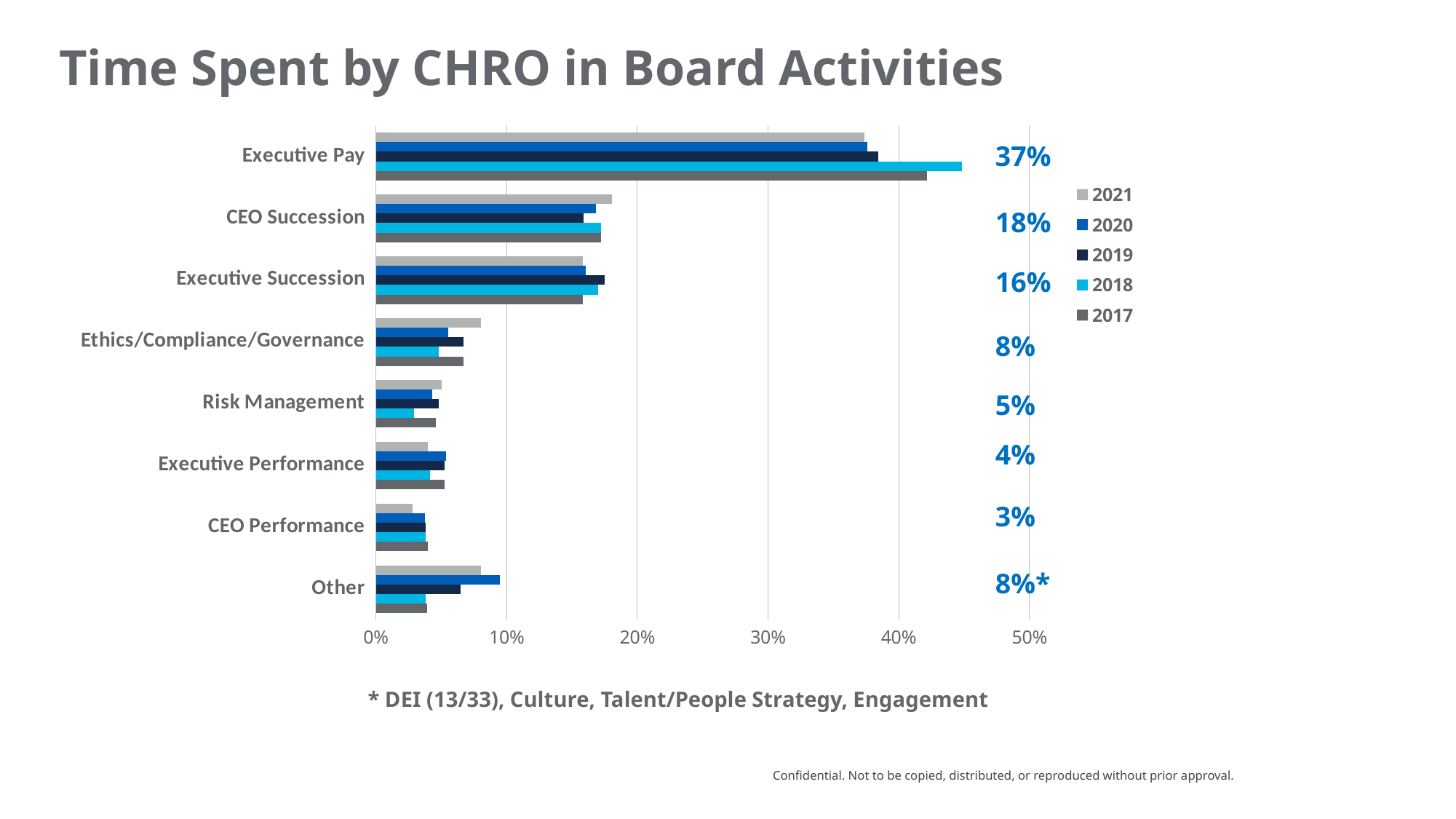
What is the difference between the printed percentages for Executive Pay and CEO Succession? 19 percentage points What kind of chart is shown on the slide? bar chart How many board activity categories are shown on the chart? 8 What percentage is printed next to CEO Succession? 18% Which board activity has the highest share of CHRO time? Executive Pay What percentage is printed next to Executive Pay? 37% Is the 2018 value for Executive Pay greater or less than 40%? greater For Executive Pay, which is larger: the 2018 bar or the 2021 bar? 2018 Based on the printed percentages, which category has the lowest value? CEO Performance What percentage is printed next to Executive Succession? 16% Is the 2018 value for Risk Management greater or less than 5%? less How many series does the legend list? 5